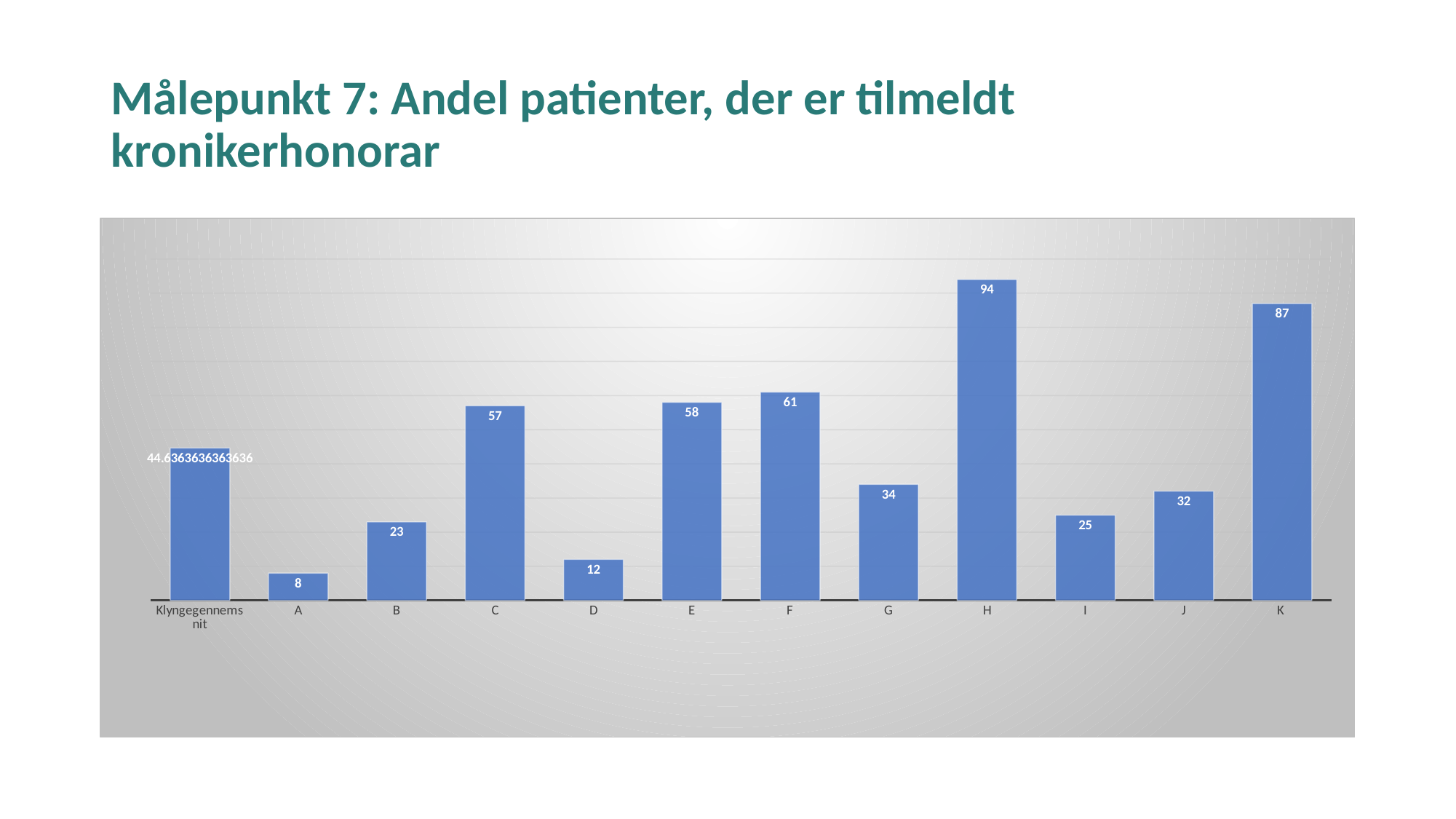
What is the difference between the values for C and D? 45 What is the title of the slide? Målepunkt 7: Andel patienter, der er tilmeldt kronikerhonorar How many bars are plotted in the chart? 12 Which is larger, the value for I or the value for E? E Which category has the lowest value? A What kind of chart is shown on the slide? Bar chart What is the difference between the values for H and K? 7 What is the value for category H? 94 What is the value for category B? 23 Which is larger, the value for G or the value for J? G What is the value shown for Klyngegennemsnit? 44.6363636363636 Which category has the highest value? H